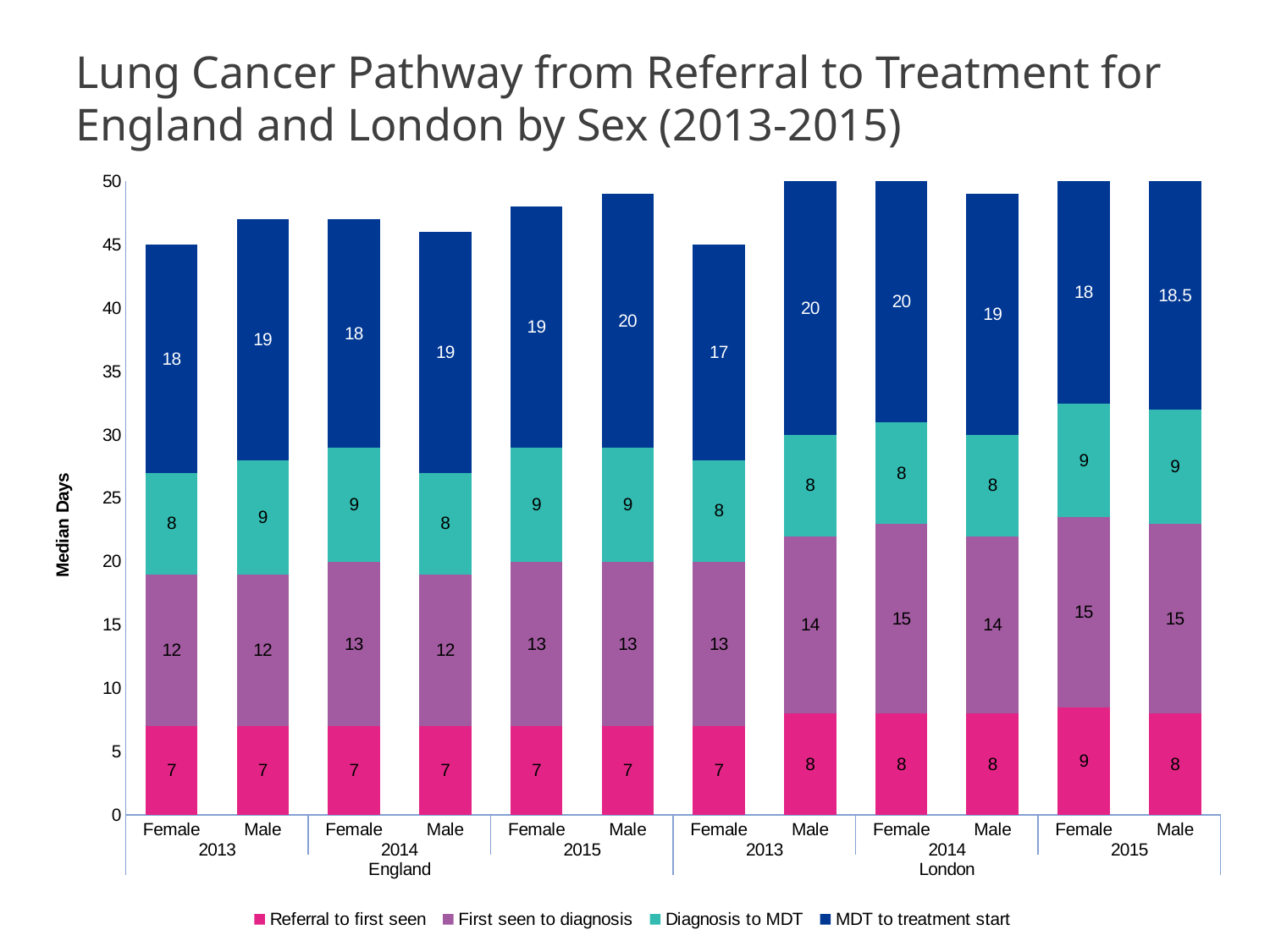
Which is larger: the MDT to treatment start value for England females in 2013 or for London females in 2013? England females in 2013 How many bars are plotted in the chart? 12 What is the median number of days from first seen to diagnosis for England females in 2014? 13 What is the median number of days from referral to first seen for London females in 2015? 9 What is the total median days for the London 2013 Male bar? 50 What is the label on the vertical axis? Median Days What is the difference in median days from first seen to diagnosis between London males and England males in 2013? 2 Is the total for the England 2015 Male bar greater or less than 45? greater What is the median number of days from MDT to treatment start for London males in 2015? 18.5 How many series does the legend list? 4 What type of chart is shown on the slide? Stacked bar chart What is the total median days for the England 2013 Female bar? 45